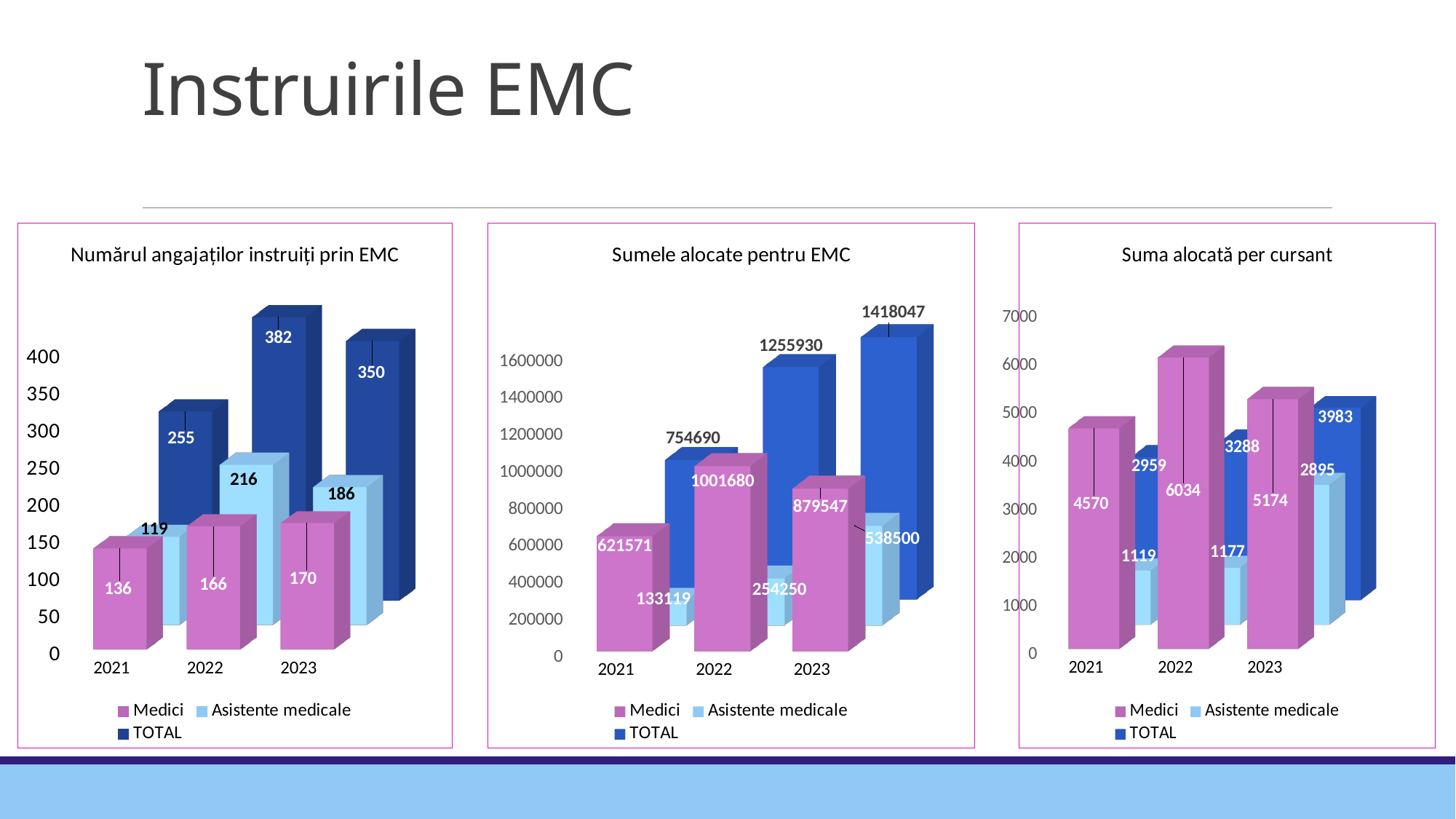
In the chart 'Numărul angajaților instruiți prin EMC', what is the value for Medici in 2022? 166 In the chart 'Suma alocată per cursant', what is the difference between the TOTAL values for 2023 and 2021? 1024 How many series does the legend of the chart 'Suma alocată per cursant' list? 3 In the chart 'Numărul angajaților instruiți prin EMC', which year has the highest TOTAL value? 2022 In the chart 'Sumele alocate pentru EMC', which year has the lowest value for Asistente medicale? 2021 In the chart 'Numărul angajaților instruiți prin EMC', how many years are shown on the x axis? 3 In the chart 'Sumele alocate pentru EMC', is the Medici value for 2022 larger or smaller than the Medici value for 2023? larger In the chart 'Sumele alocate pentru EMC', what is the TOTAL value for 2023? 1418047 In the chart 'Suma alocată per cursant', what is the value for Asistente medicale in 2023? 2895 In the chart 'Numărul angajaților instruiți prin EMC', what is the difference between the Asistente medicale values for 2022 and 2021? 97 In the chart 'Sumele alocate pentru EMC', does the TOTAL value rise or fall from 2021 to 2023? rise In the chart 'Suma alocată per cursant', which year has the highest Medici value? 2022